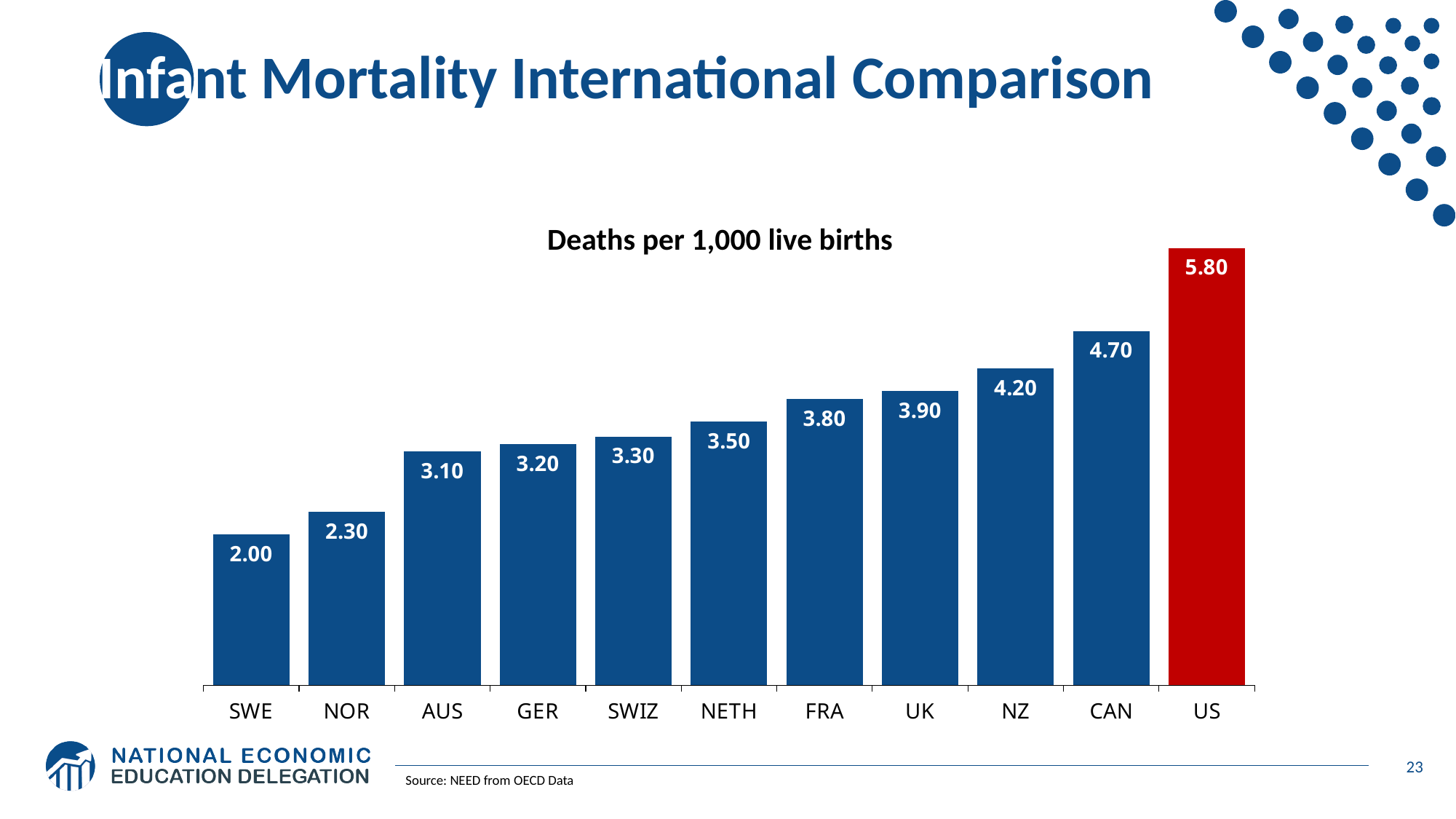
What is the value for GER in the chart? 3.20 What is the difference between the values for AUS and SWE? 1.10 Do the values rise or fall from left to right across the chart? Rise What is the difference between the values for the US and CAN? 1.10 What is the value for the US in the chart? 5.80 What kind of chart is shown on the slide? Bar chart What is the title of the chart? Deaths per 1,000 live births What is the value for NOR in the chart? 2.30 Which country has the lowest value in the chart? SWE How many countries are shown in the chart? 11 Which country has the highest value in the chart? US Which has a larger value, FRA or NETH? FRA